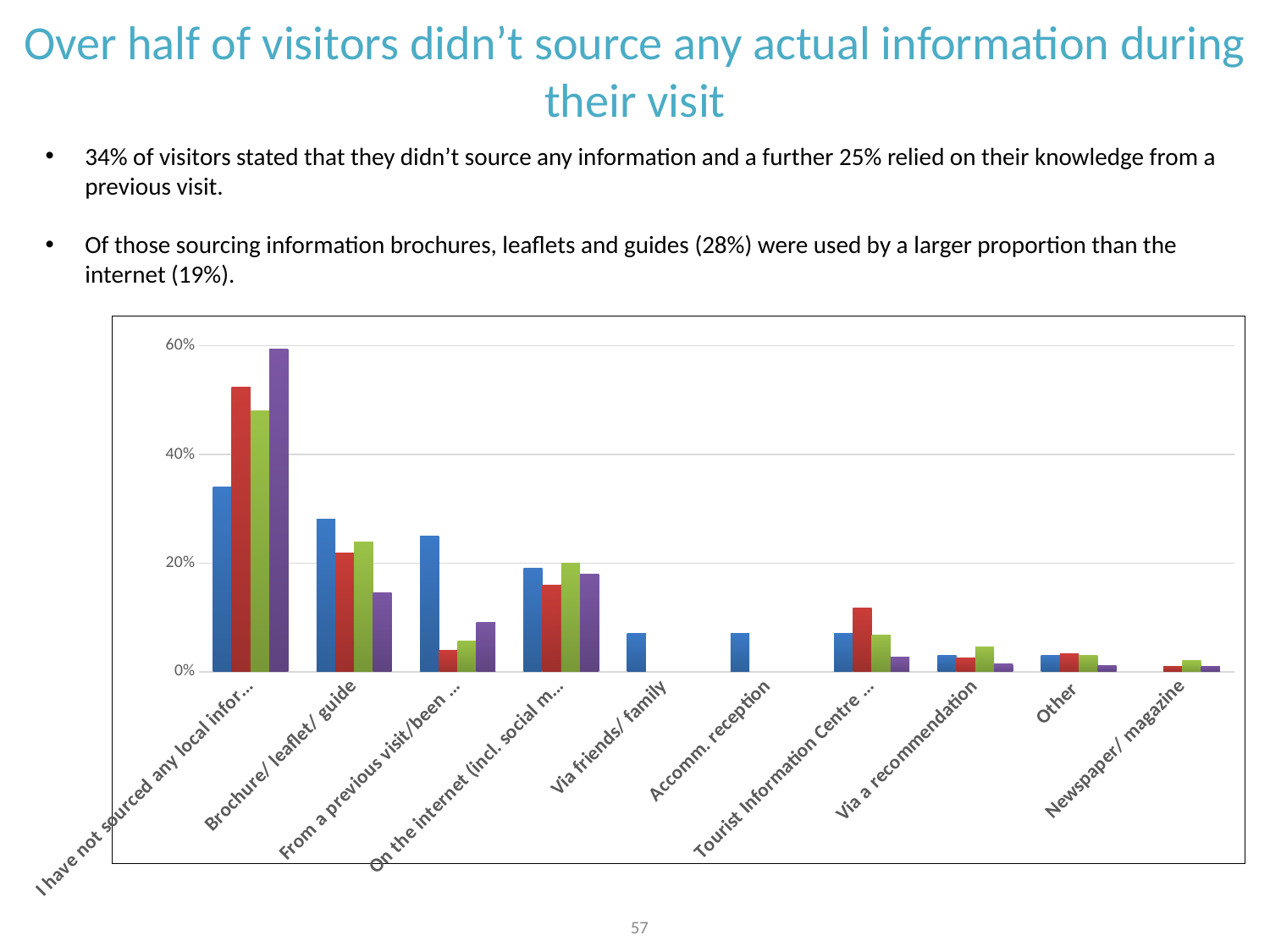
Is the blue bar for Brochure/ leaflet/ guide greater or less than 20%? greater How many bars are visible for the Accomm. reception category? 1 How many categories are shown along the x axis of the chart? 10 For the Brochure/ leaflet/ guide category, which is taller: the blue bar or the purple bar? the blue bar What is the highest value labelled on the y axis of the chart? 60% Is the purple bar for the leftmost category on the x axis greater or less than 40%? greater Is the green bar for the leftmost category on the x axis greater or less than 40%? greater Which has the taller blue bar: Via friends/ family or Other? Via friends/ family How many bars are shown for the Brochure/ leaflet/ guide category? 4 What kind of chart is shown on the slide? bar chart